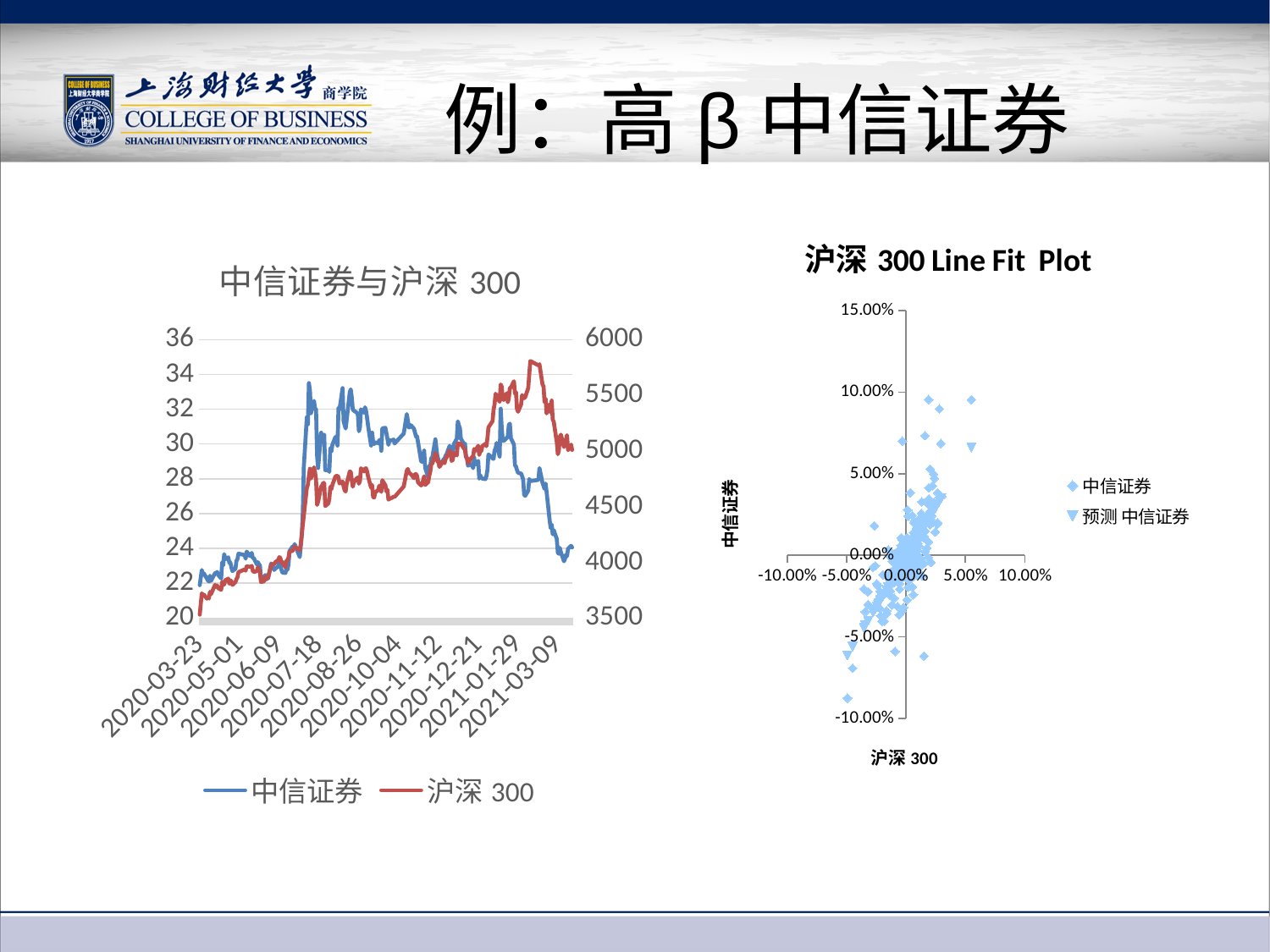
In the left chart 中信证券与沪深 300, is the value of 沪深 300 at 2020-03-23 greater or less than 4000? less In the left chart 中信证券与沪深 300, is the highest value reached by 中信证券 greater or less than 32? greater In the left chart 中信证券与沪深 300, is the value of 沪深 300 at 2021-03-09 greater or less than 4500? greater In the right chart 沪深 300 Line Fit Plot, what is the title of the vertical axis? 中信证券 How many series does the legend of the left chart 中信证券与沪深 300 list? 2 What is the title of the right chart on the slide? 沪深 300 Line Fit Plot What kind of chart is the left chart titled 中信证券与沪深 300? line chart In the right chart 沪深 300 Line Fit Plot, what is the highest tick value shown on the vertical axis? 15.00% In the left chart 中信证券与沪深 300, does the 沪深 300 series overall rise or fall from 2020-03-23 to 2021-03-09? rise How many series does the legend of the right chart 沪深 300 Line Fit Plot list? 2 What kind of chart is the right chart titled 沪深 300 Line Fit Plot? scatter chart